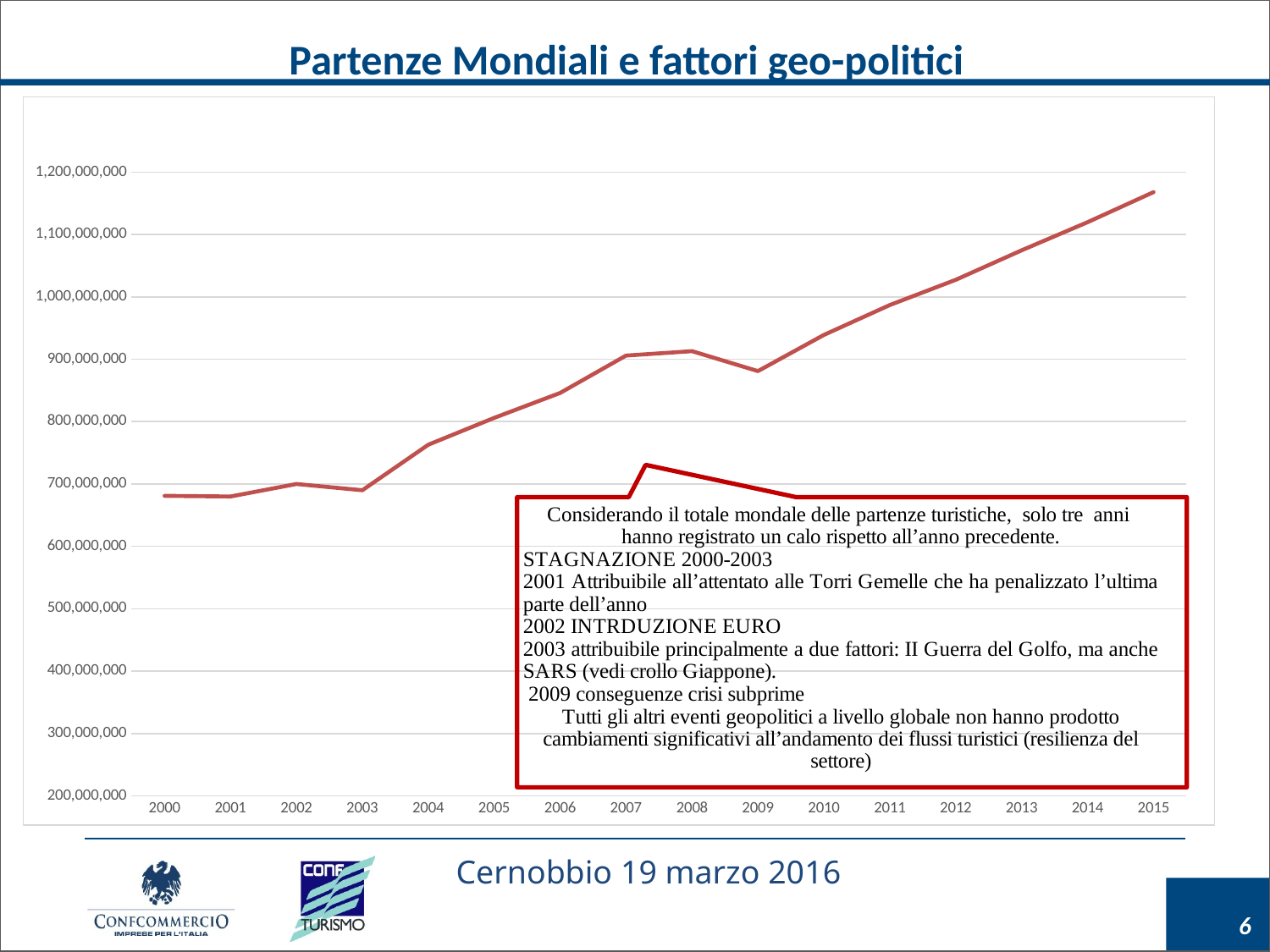
Is the value for 2004 greater or less than 800,000,000? less Overall, do the values rise or fall from 2000 to 2015? rise Is the value for 2010 greater or less than 900,000,000? greater Which year has the larger value, 2000 or 2015? 2015 Which year has the larger value, 2008 or 2009? 2008 Is the value for 2012 greater or less than 1,000,000,000? greater How many years are plotted along the x axis of the chart? 16 What is the highest tick value shown on the y axis of the chart? 1,200,000,000 Which year has the highest value on the chart? 2015 What kind of chart is shown on the slide? line chart